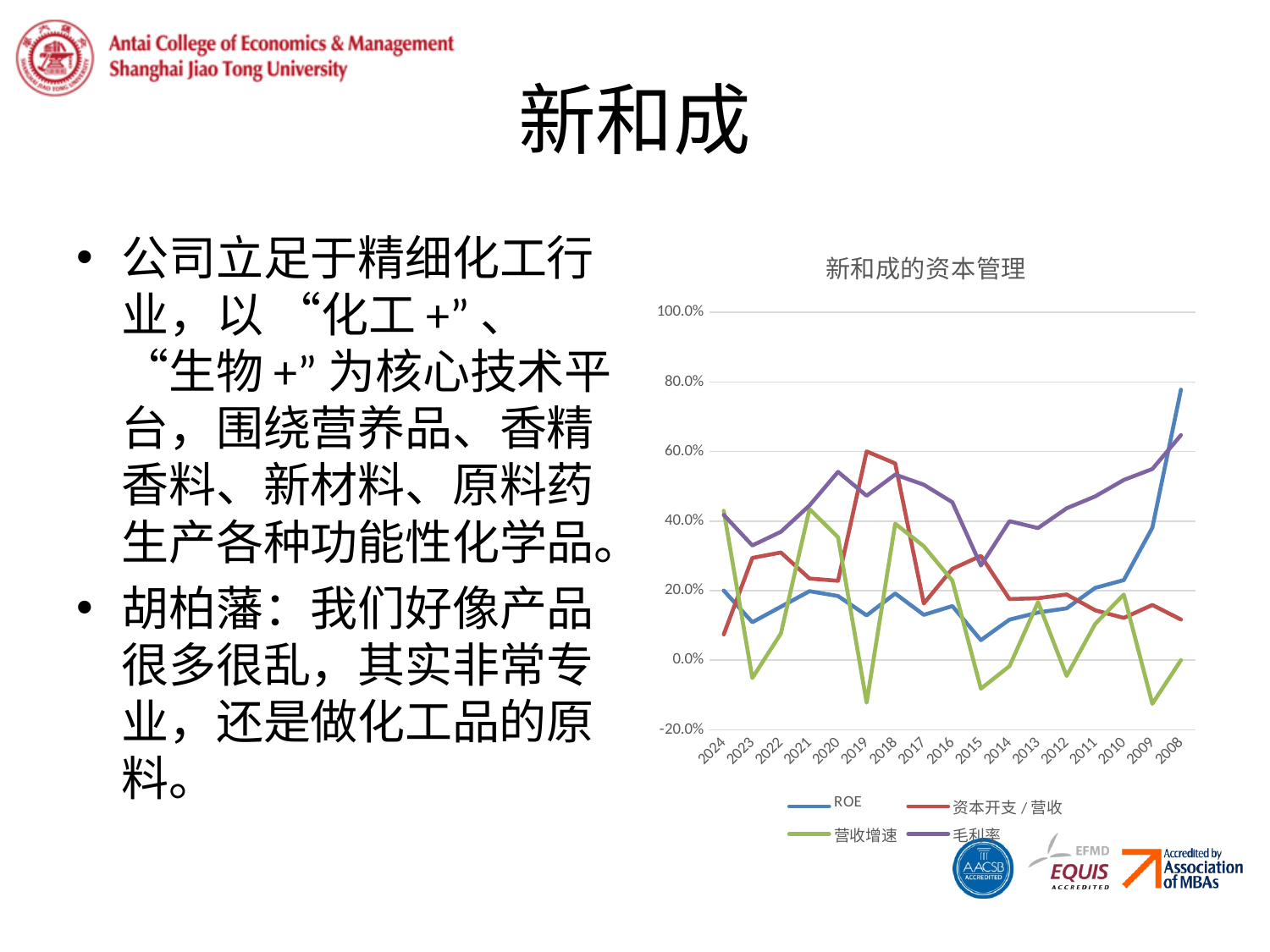
In 2019, which is larger: 资本开支/营收 or ROE? 资本开支/营收 Is the 资本开支/营收 value for 2024 greater or less than 20.0%? less How many years are plotted along the x axis of the chart? 17 In 2024, which is larger: 营收增速 or ROE? 营收增速 What is the title of the chart? 新和成的资本管理 Is the 营收增速 value for 2019 greater or less than 0.0%? less In which year does ROE reach its highest value? 2008 Which series is drawn in blue in the chart? ROE Is the ROE value for 2008 greater or less than 60.0%? greater What kind of chart is shown on the slide? line chart How many series does the chart legend list? 4